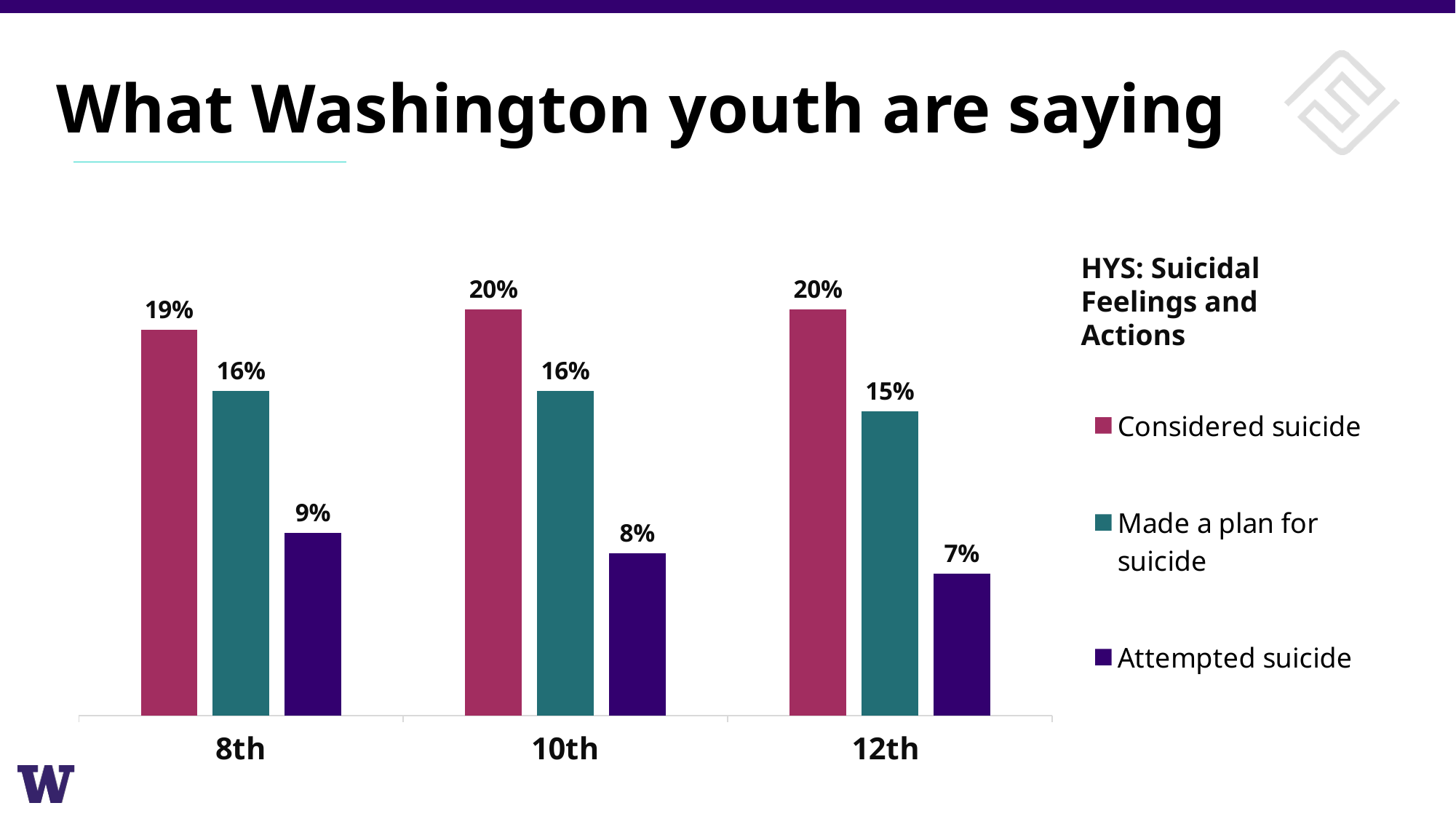
What percentage of 8th graders considered suicide? 19% Does the 'Attempted suicide' series rise or fall from 8th to 12th grade? Fall Which grade has the lowest value for 'Considered suicide'? 8th How many series does the legend list? 3 What kind of chart is shown on the slide? Bar chart What is the difference between 'Considered suicide' and 'Attempted suicide' for 10th graders? 12% What is the value for 'Made a plan for suicide' among 12th graders? 15% Which grade has the lowest value for 'Attempted suicide'? 12th How many grade categories are shown on the x axis? 3 What percentage of 10th graders attempted suicide? 8% Which is larger: 'Attempted suicide' for 8th graders or for 12th graders? 8th graders What is the difference between 'Made a plan for suicide' for 8th graders and 12th graders? 1%